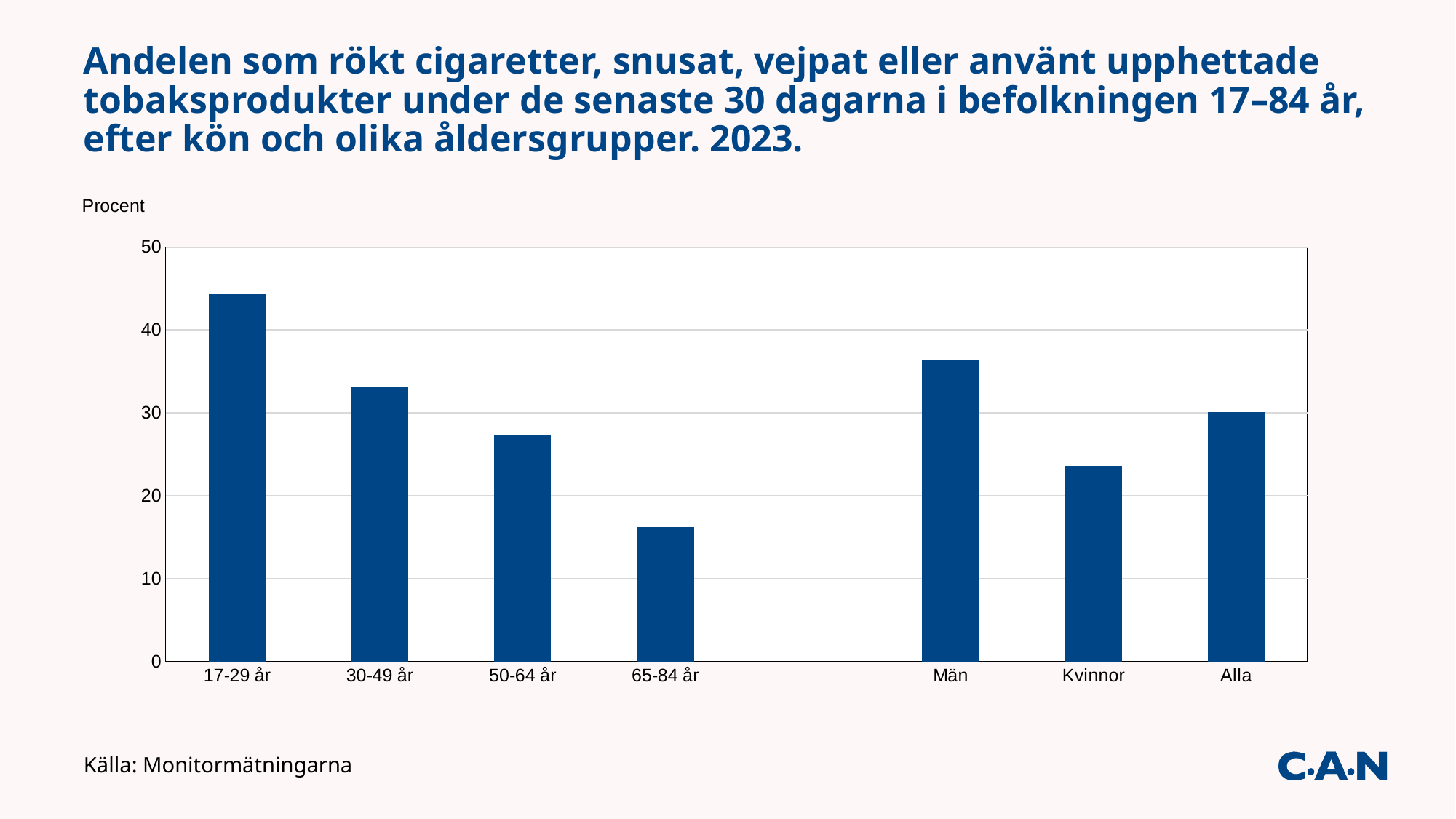
Is the value for Kvinnor greater or less than 20? greater Which category has the lowest bar? 65-84 år Which is larger, the value for 30-49 år or the value for 50-64 år? 30-49 år Do the values rise or fall across the age groups from 17-29 år to 65-84 år? fall Is the value for 65-84 år greater or less than 20? less Which is larger, the value for Män or the value for Kvinnor? Män Is the value for Män greater or less than 40? less What kind of chart is shown on the slide? bar chart Which category has the highest bar? 17-29 år How many bars are plotted in the chart? 7 What unit is shown on the vertical axis label? Procent